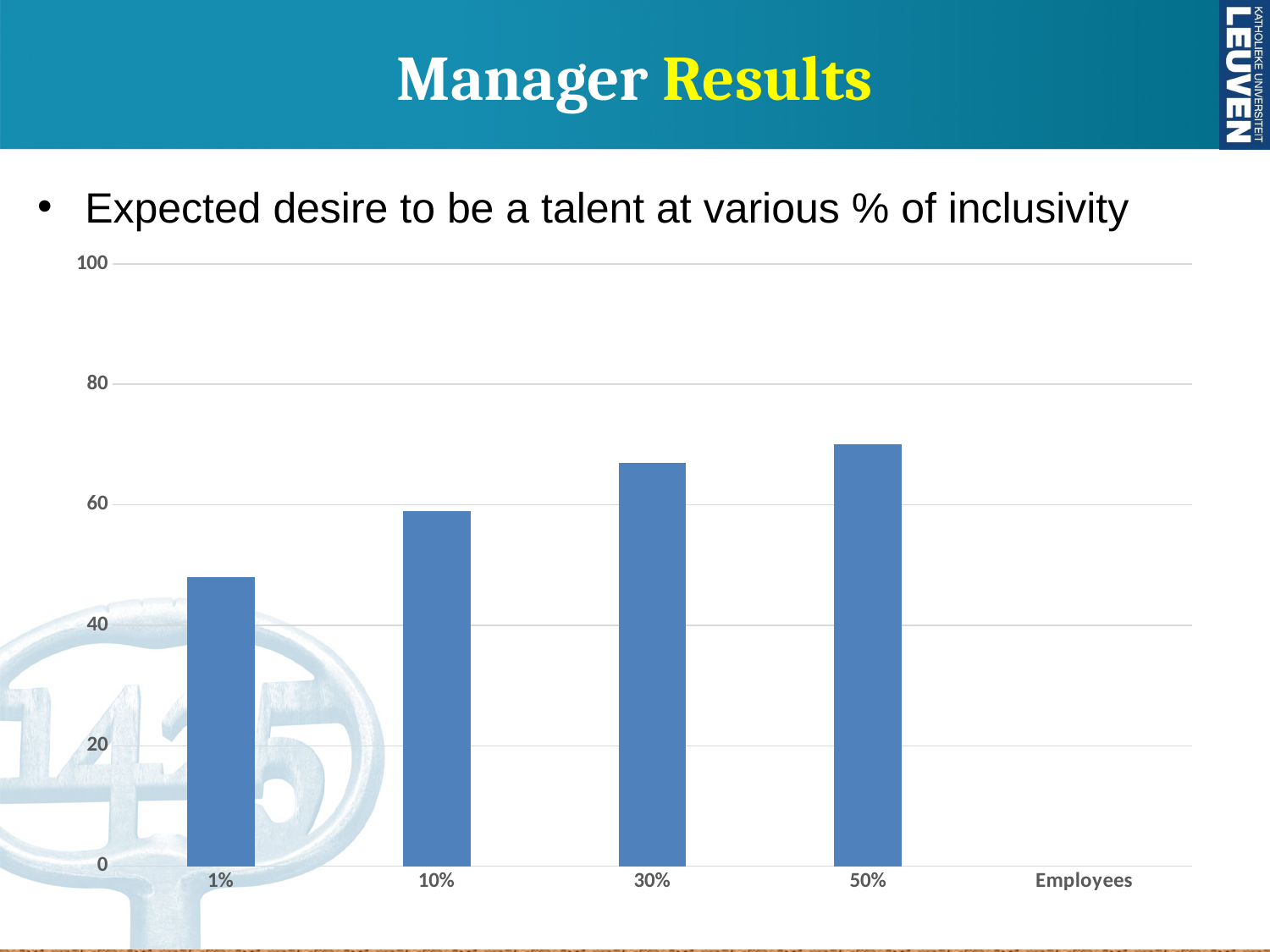
Is the value for 1% greater or less than 40? greater What kind of chart is shown on the slide? bar chart Is the value for 1% greater or less than 60? less Which is larger, the value for 1% or the value for 10%? 10% What is the highest value shown on the vertical axis? 100 How many bars are plotted in the chart? 4 Which category has the tallest bar? 50% Is the value for 30% greater or less than 60? greater Do the bar values rise or fall from 1% to 50% along the x axis? rise Which category has the shortest bar? 1%